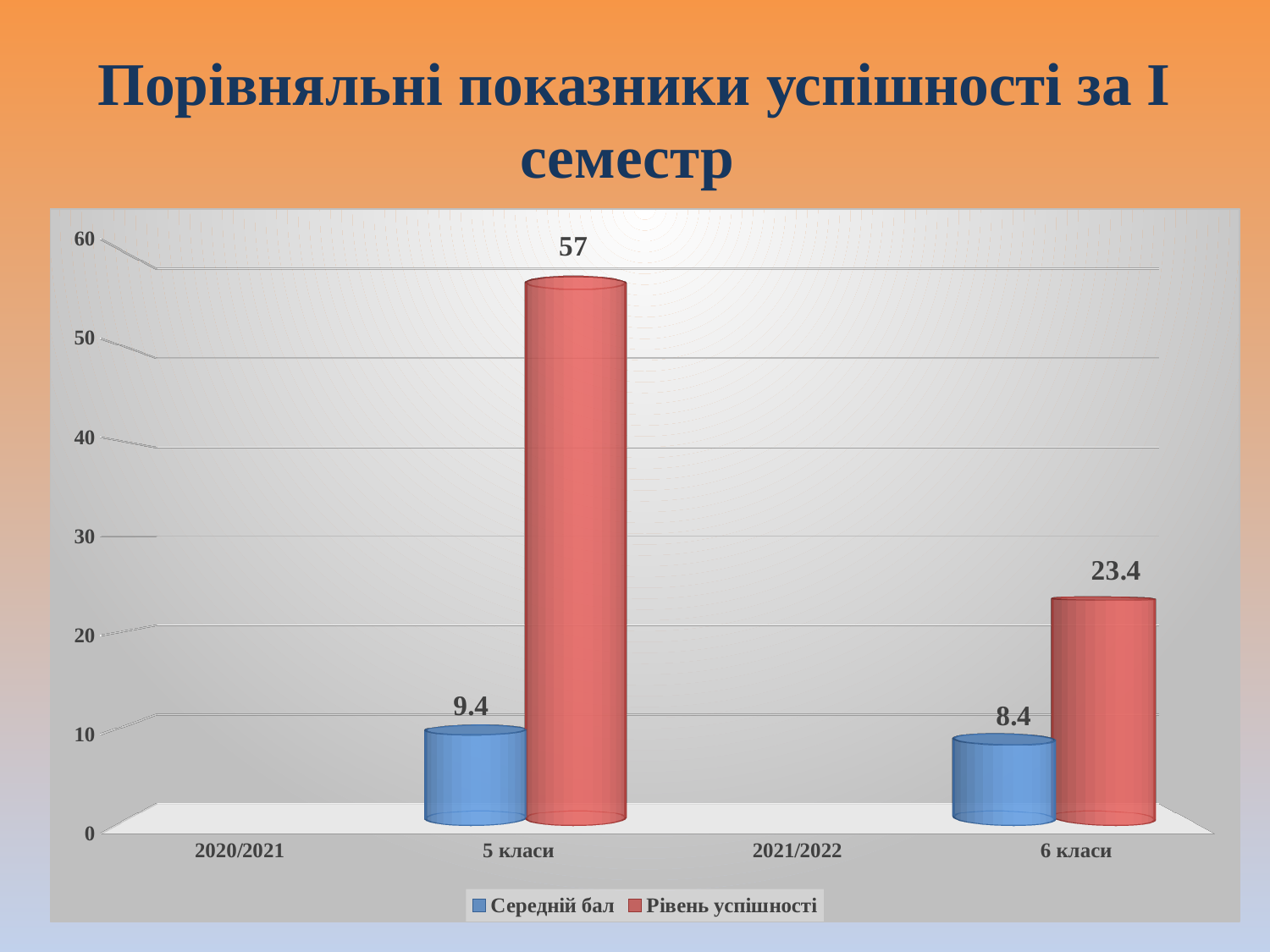
What is the value of Середній бал for 5 класи? 9.4 What is the difference between the Середній бал values for 5 класи and 6 класи? 1 How many series does the legend list? 2 What kind of chart is shown on the slide? bar chart What is the value of Рівень успішності for 6 класи? 23.4 Which category has the highest Рівень успішності value? 5 класи Is the Рівень успішності value for 6 класи greater or less than 30? less Which category has the lowest Середній бал value? 6 класи Which is larger: Рівень успішності for 5 класи or for 6 класи? 5 класи What is the difference between the Рівень успішності values for 5 класи and 6 класи? 33.6 What is the value of Рівень успішності for 5 класи? 57 What is the value of Середній бал for 6 класи? 8.4